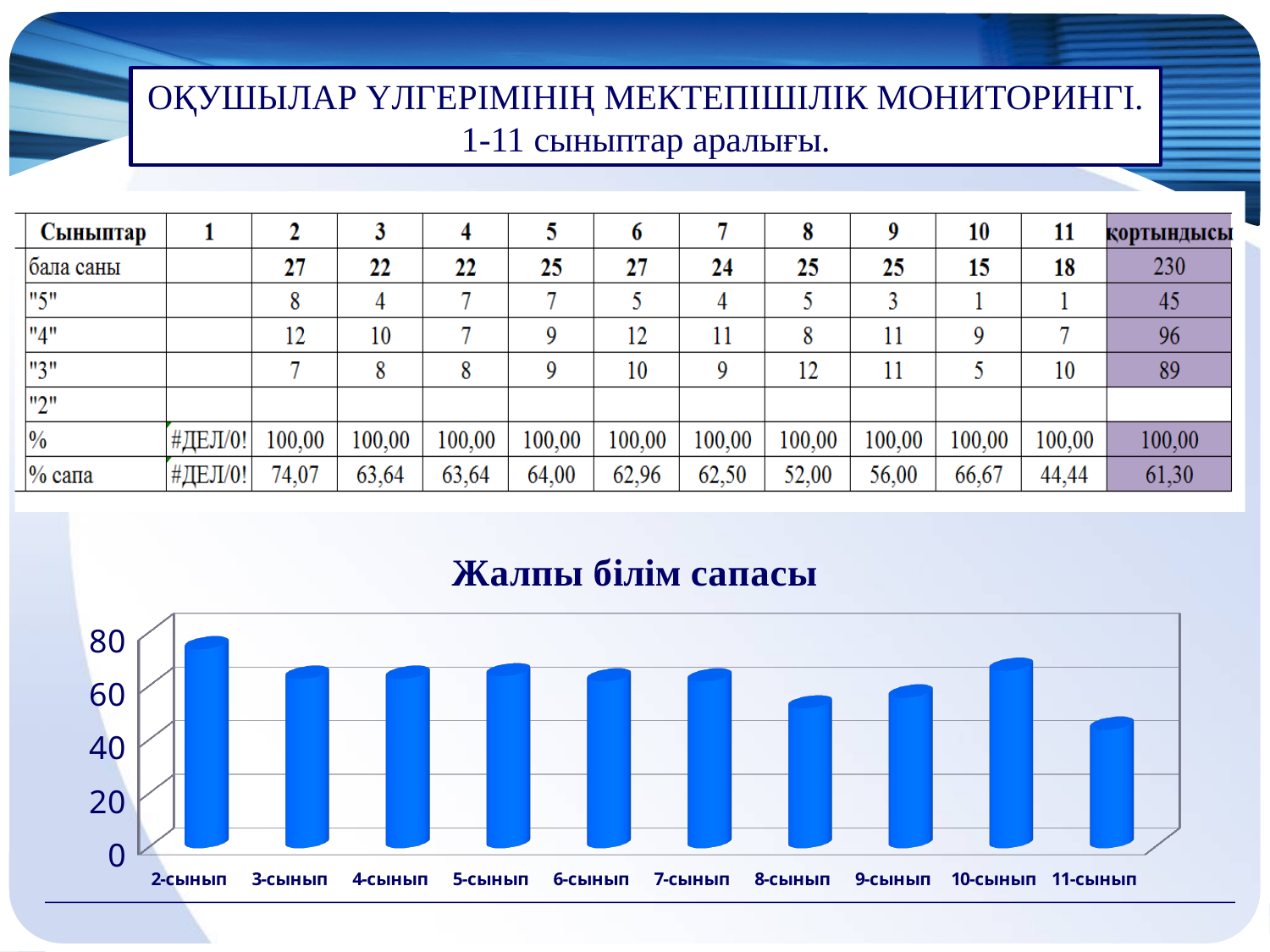
What kind of chart is shown on the slide? bar chart How many bars (classes) are shown in the chart? 10 Which class has the lowest bar in the chart? 11-сынып Is the value for 8-сынып greater or less than 60? less Which is larger, the value for 8-сынып or the value for 10-сынып? 10-сынып Is the value for 2-сынып greater or less than 60? greater What is the title of the chart? Жалпы білім сапасы Which class has the highest bar in the chart? 2-сынып Which is larger, the value for 2-сынып or the value for 11-сынып? 2-сынып What is the highest value shown on the vertical axis of the chart? 80 Is the value for 10-сынып greater or less than 60? greater